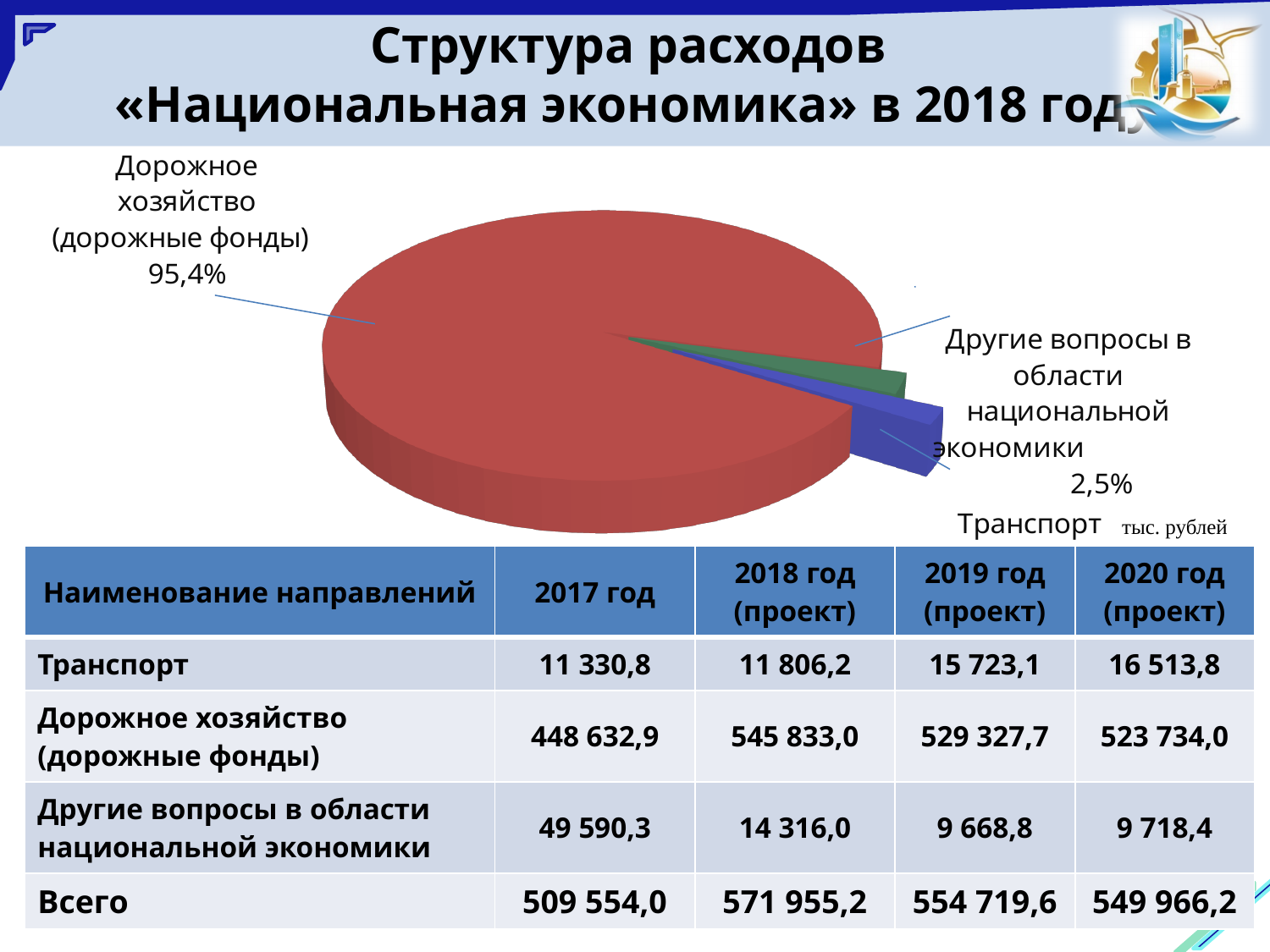
How many slices does the pie chart have? 3 What is the title of the slide containing the pie chart? Структура расходов «Национальная экономика» в 2018 год What colour is the largest slice of the pie chart? Red What kind of chart is shown on the slide? Pie chart By how many percentage points does the share of «Дорожное хозяйство (дорожные фонды)» exceed the share of «Другие вопросы в области национальной экономики» in the pie chart? 92,9 Which slice is larger in the pie chart: «Дорожное хозяйство (дорожные фонды)» or «Другие вопросы в области национальной экономики»? Дорожное хозяйство (дорожные фонды) What share of the pie chart does «Другие вопросы в области национальной экономики» have? 2,5% What share of the pie chart does «Дорожное хозяйство (дорожные фонды)» have? 95,4% Which category has the largest slice in the pie chart? Дорожное хозяйство (дорожные фонды)